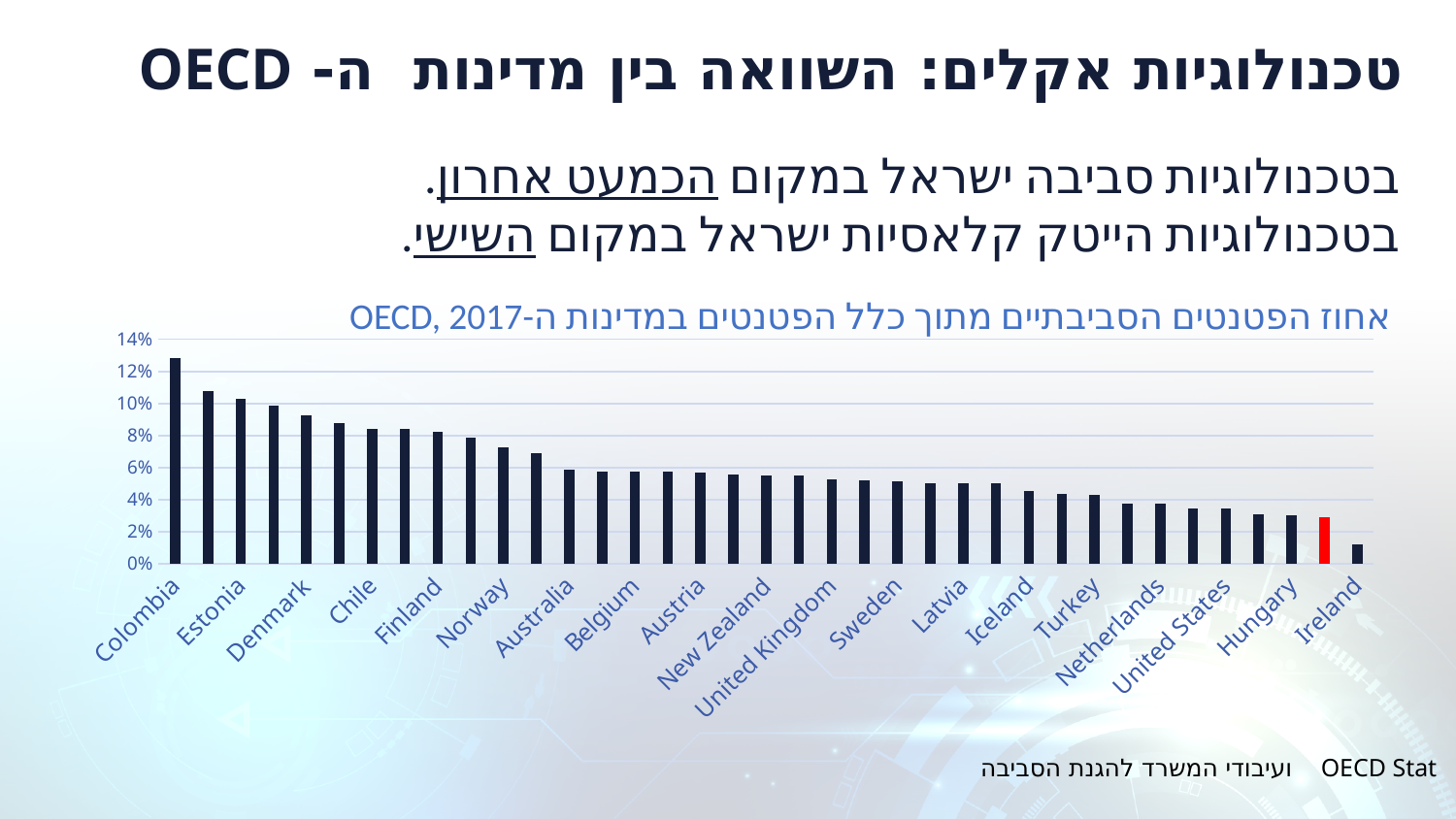
What kind of chart is shown on the slide? bar chart What colour is the single highlighted bar near the right end of the chart? red Which country has the lowest share of environmental patents in the chart? Ireland Which is larger, the value for Colombia or the value for Estonia? Colombia Is the value for Colombia greater or less than 12%? greater Is the value for Denmark greater or less than 10%? less Do the values rise or fall moving from left to right along the x axis? fall Which country has the highest share of environmental patents in the chart? Colombia Is the value for Norway greater or less than 8%? less